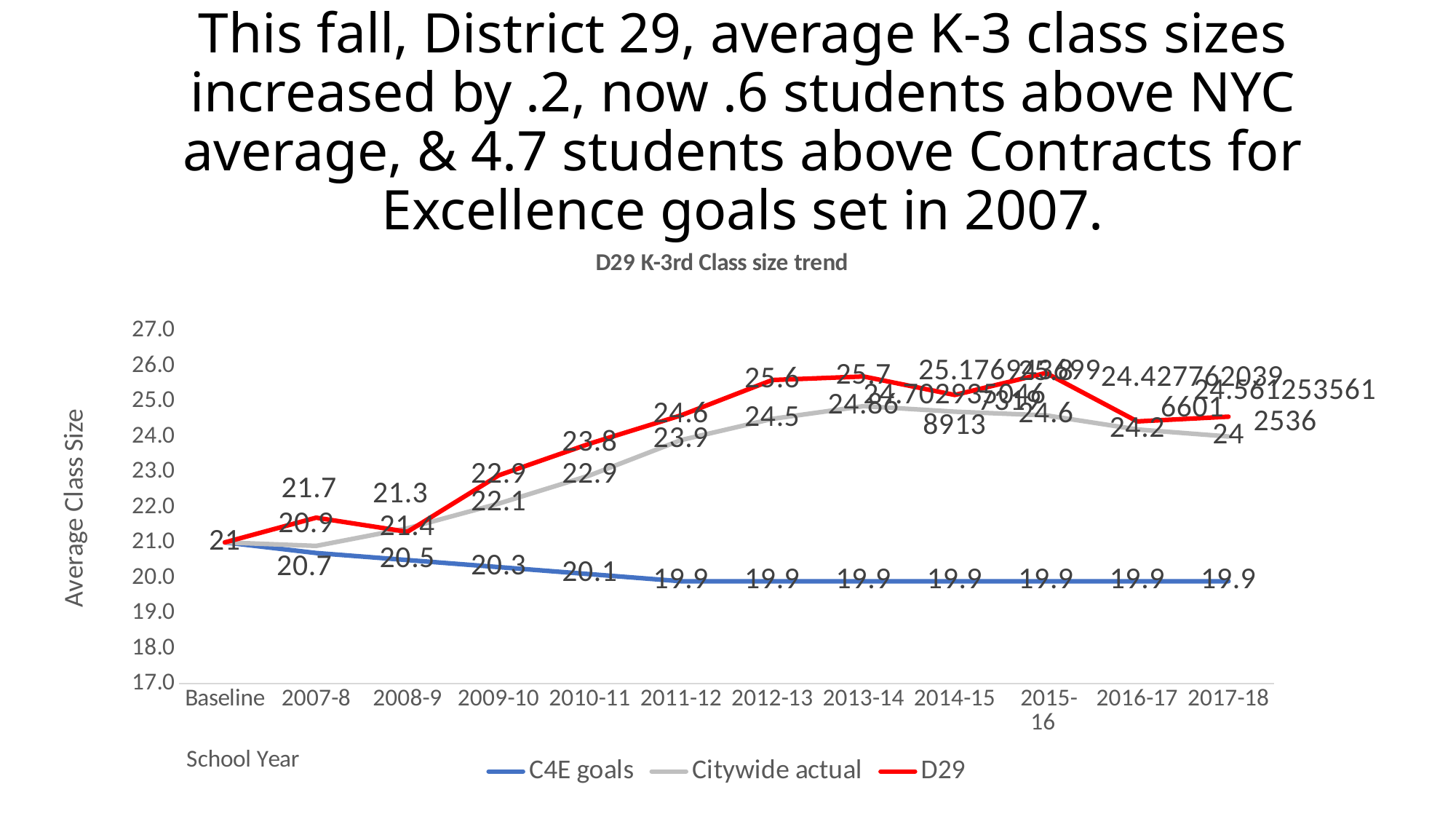
What is the C4E goals value for 2017-18? 19.9 Do the C4E goals values rise or fall from Baseline to 2011-12? fall What is the D29 value for 2012-13? 25.6 What kind of chart is shown on the slide? line chart How many series does the legend list? 3 What is the D29 value for 2013-14? 25.7 What is the title of the chart? D29 K-3rd Class size trend What is the difference between the D29 value and the Citywide actual value in 2012-13? 1.1 In 2010-11, which is larger: the D29 value or the Citywide actual value? D29 How many school-year categories are shown on the x axis? 12 What is the Citywide actual value for 2011-12? 23.9 Is the D29 value for 2015-16 greater or less than 25.0? greater